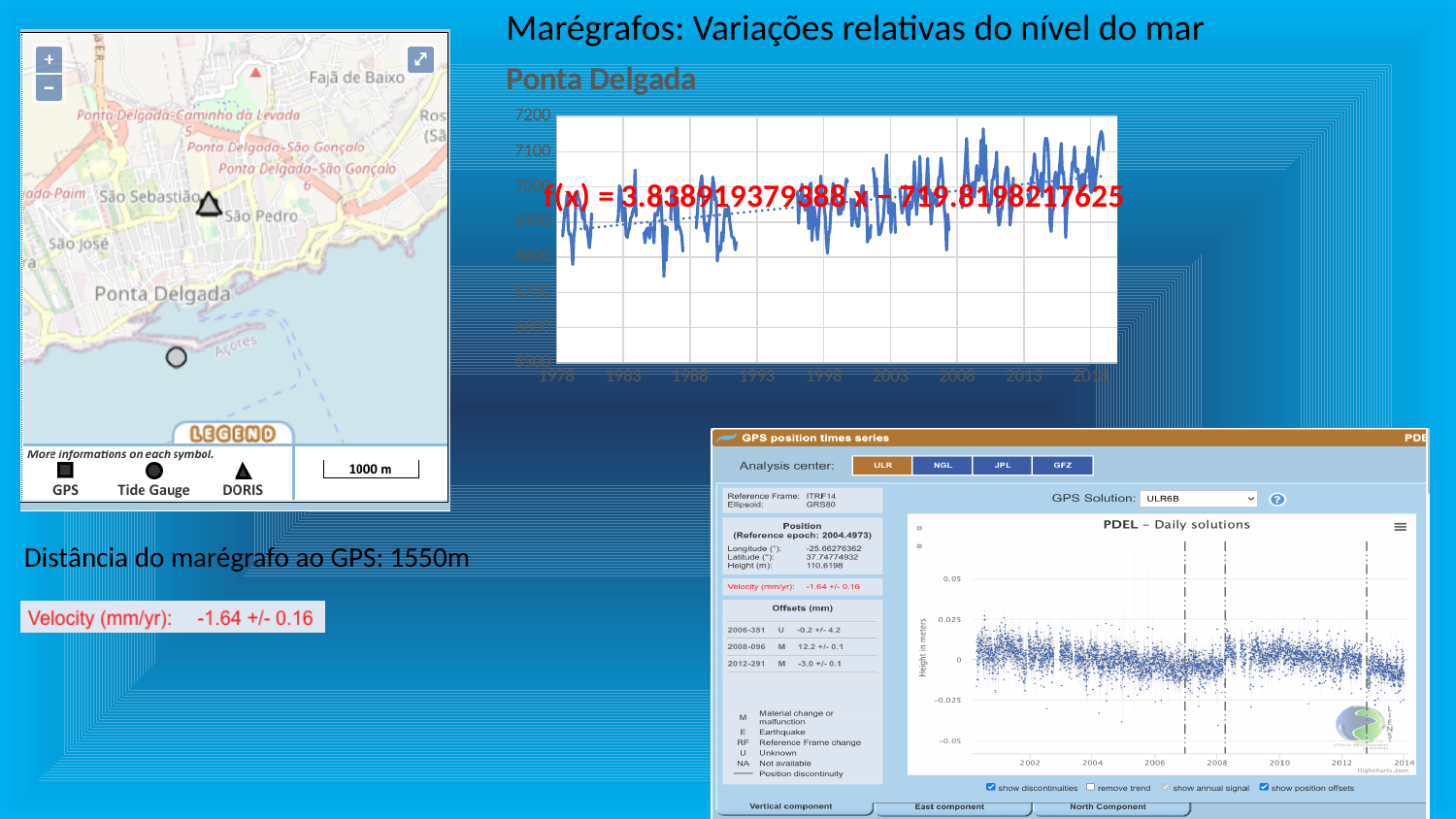
What is the slope of the trend line equation printed on the 'Ponta Delgada' chart? 3.8389193793888 In the 'Ponta Delgada' chart, do the values generally rise or fall from 1978 to 2018? rise What is the full trend line equation printed on the 'Ponta Delgada' chart? f(x) = 3.8389193793888 x − 719.8198217625 In the 'Ponta Delgada' chart, are the values around 1980 greater or less than 7100? less In the 'PDEL – Daily solutions' chart, what is the last year label on the x axis? 2014 What kind of chart is the 'Ponta Delgada' chart at the top right of the slide? line chart What is the title of the GPS chart at the bottom right of the slide? PDEL – Daily solutions What velocity (mm/yr) is printed on the slide for the GPS station? -1.64 +/- 0.16 In the 'PDEL – Daily solutions' chart, what is the first year label on the x axis? 2002 In the 'Ponta Delgada' chart, are the values around 2016 greater or less than 6800? greater In the 'Ponta Delgada' chart, what is the highest value shown on the y axis? 7200 In the 'Ponta Delgada' chart, what is the first year label on the x axis? 1978